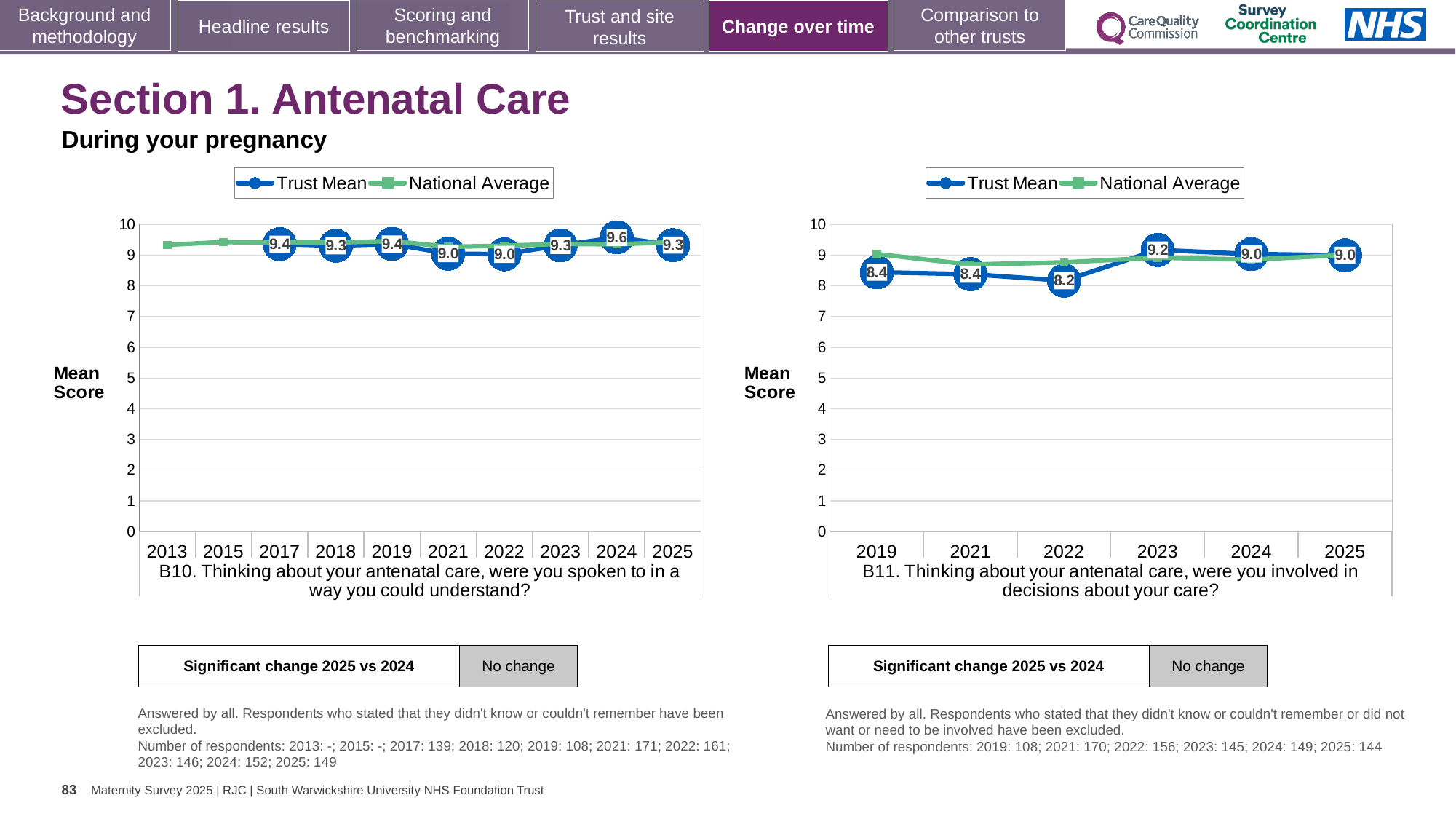
In the B10 chart (left), what is the Trust Mean for 2021? 9.0 In the B10 chart (left), what is the Trust Mean for 2024? 9.6 In the B10 chart (left), how many years are shown on the x axis? 10 In the B11 chart (right), is the Trust Mean higher in 2023 or in 2021? 2023 In the B11 chart (right), what is the Trust Mean for 2022? 8.2 In the B10 chart (left), which year has the highest Trust Mean? 2024 How many series does the legend of the B11 chart (right) list? 2 In the B10 chart (left), what is the difference between the Trust Mean in 2024 and in 2025? 0.3 What kind of chart is the B10 chart (left)? Line chart In the B11 chart (right), which year has the lowest Trust Mean? 2022 In the B11 chart (right), which year has the highest Trust Mean? 2023 In the B11 chart (right), is the National Average for 2019 greater or less than 8? greater